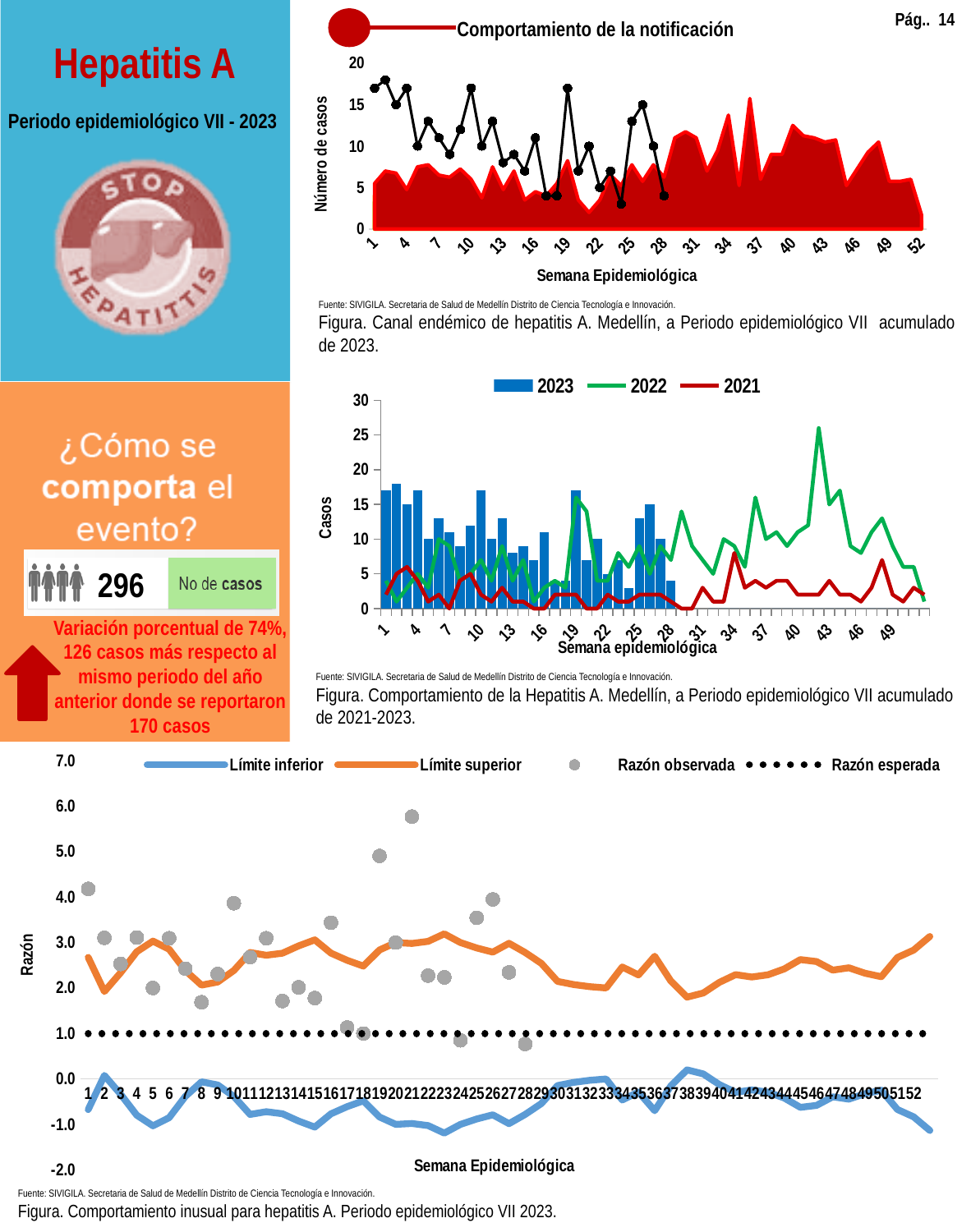
In the middle chart (Comportamiento de la Hepatitis A 2021-2023), which series is shown as bars? 2023 In the bottom chart (Comportamiento inusual), is the Límite inferior at week 23 greater or less than 0.0? less In the middle chart (Comportamiento de la Hepatitis A 2021-2023), which series reaches the highest value on the chart? 2022 In the middle chart (Comportamiento de la Hepatitis A 2021-2023), is the 2023 value at week 1 greater or less than 15? greater In the bottom chart (Comportamiento inusual), at what constant value does the Razón esperada dotted line sit? 1.0 In the top chart (Comportamiento de la notificación), what is the y-axis title? Número de casos In the bottom chart (Comportamiento inusual), is the Razón observada at week 21 greater or less than 5.0? greater In the middle chart (Comportamiento de la Hepatitis A 2021-2023), at week 2, which is larger: the 2023 value or the 2021 value? 2023 In the middle chart (Comportamiento de la Hepatitis A 2021-2023), how many series does the legend list? 3 In the bottom chart (Comportamiento inusual), how many series does the legend list? 4